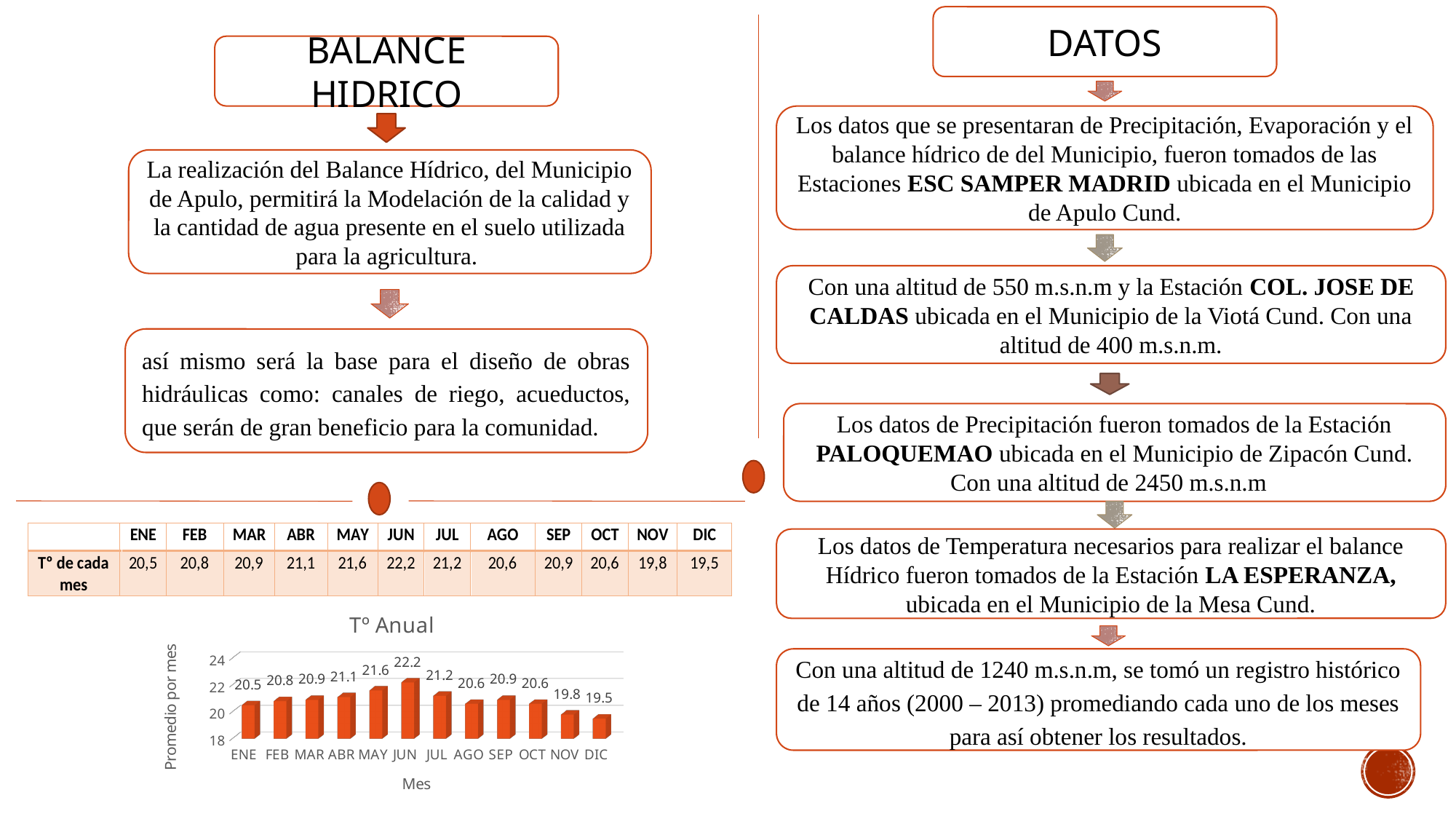
In the Tº Anual chart, is the value for NOV greater or less than 20? less Which month has the highest value in the Tº Anual chart? JUN How many months are plotted in the Tº Anual chart? 12 What is the value for ABR in the Tº Anual chart? 21.1 In the Tº Anual chart, do the values rise or fall from ENE to JUN? rise In the Tº Anual chart, which is larger, the value for MAY or the value for JUL? MAY What is the title of the chart on the slide? Tº Anual What kind of chart is the Tº Anual chart? bar chart Which month has the lowest value in the Tº Anual chart? DIC What is the difference between the values for JUN and DIC in the Tº Anual chart? 2.7 What is the value for JUN in the Tº Anual chart? 22.2 What is the label of the vertical axis in the Tº Anual chart? Promedio por mes